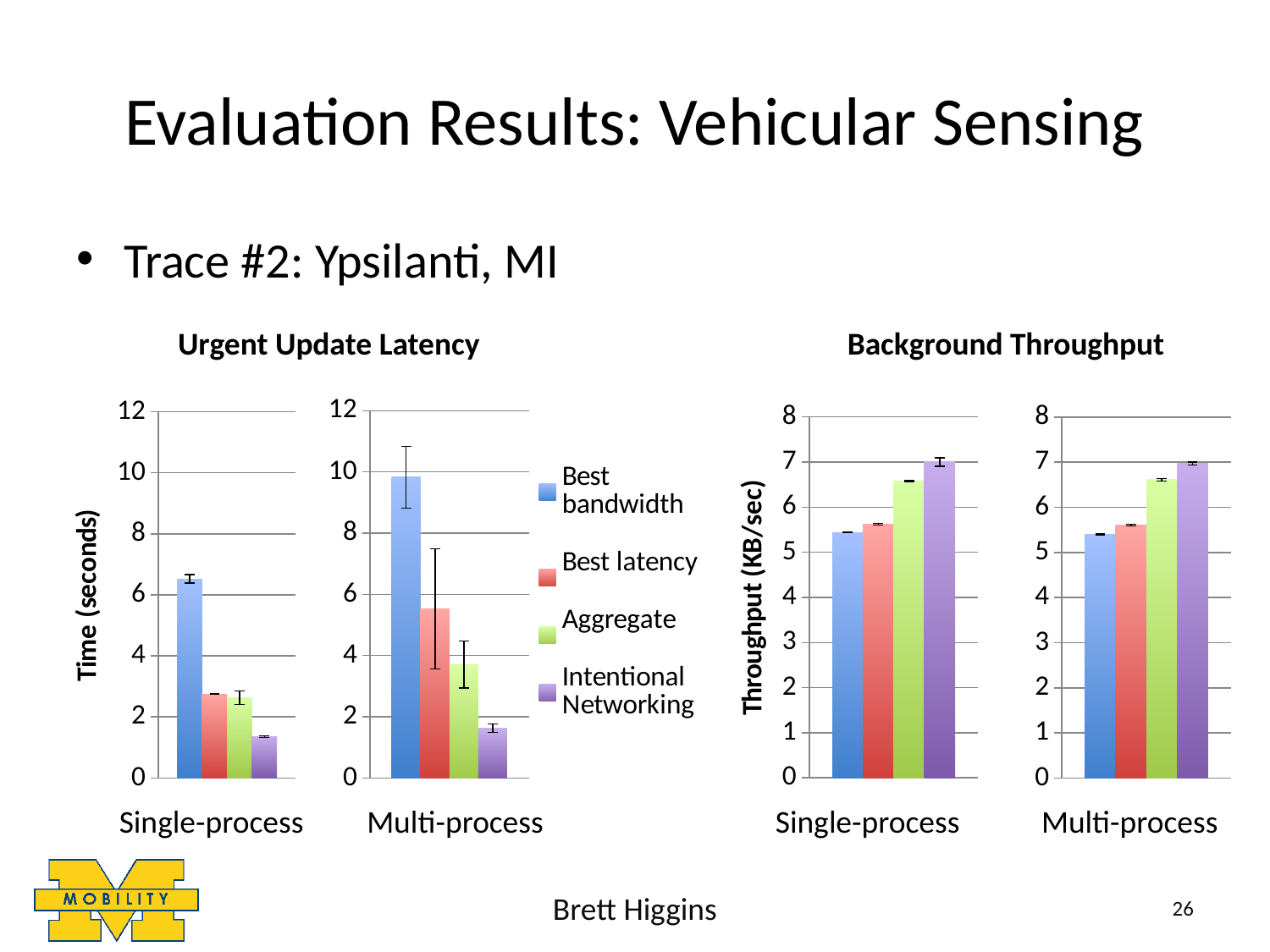
In the Urgent Update Latency Single-process chart, which series has the highest latency? Best bandwidth In the Urgent Update Latency Multi-process chart, is the value for Best bandwidth greater or less than 8 seconds? greater In the Background Throughput Multi-process chart, is the value for Aggregate greater or less than 6 KB/sec? greater In the Urgent Update Latency Single-process chart, is the value for Best bandwidth greater or less than 6 seconds? greater In the Urgent Update Latency Single-process chart, which series has the lowest latency? Intentional Networking In the Urgent Update Latency Multi-process chart, which series has the highest latency? Best bandwidth What kind of chart is the Background Throughput Single-process chart? Bar chart How many series does the legend on the slide list? 4 In the Urgent Update Latency Multi-process chart, which series has the lowest latency? Intentional Networking In the Background Throughput Single-process chart, which series has the highest throughput? Intentional Networking In the Background Throughput Multi-process chart, which is larger, the throughput for Best latency or for Intentional Networking? Intentional Networking